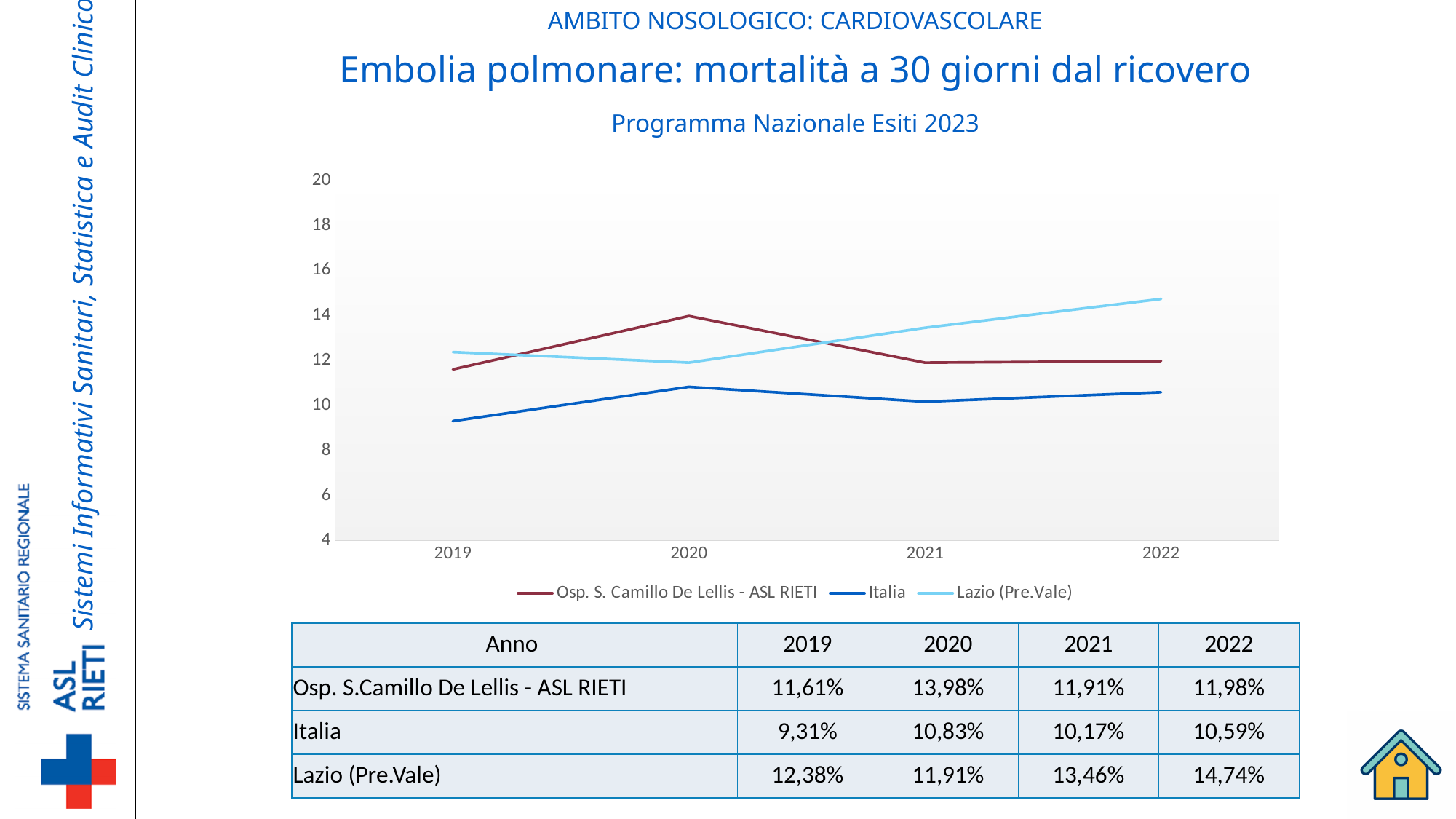
What kind of chart is shown on the slide? line chart In which year is the Italia series at its lowest value? 2019 What is the value for Lazio (Pre.Vale) in 2022? 14,74% What is the value for Osp. S.Camillo De Lellis - ASL RIETI in 2020? 13,98% What is the value for Italia in 2019? 9,31% Does the Lazio (Pre.Vale) series rise or fall from 2020 to 2022? rise How many series does the chart legend list? 3 Which series has the higher value in 2021, Osp. S.Camillo De Lellis - ASL RIETI or Lazio (Pre.Vale)? Lazio (Pre.Vale) What is the difference between the Lazio (Pre.Vale) value and the Italia value in 2022? 4,15% In which year does the Osp. S.Camillo De Lellis - ASL RIETI series reach its highest value? 2020 How many years are plotted along the x axis of the chart? 4 Which series is drawn in light blue in the chart? Lazio (Pre.Vale)